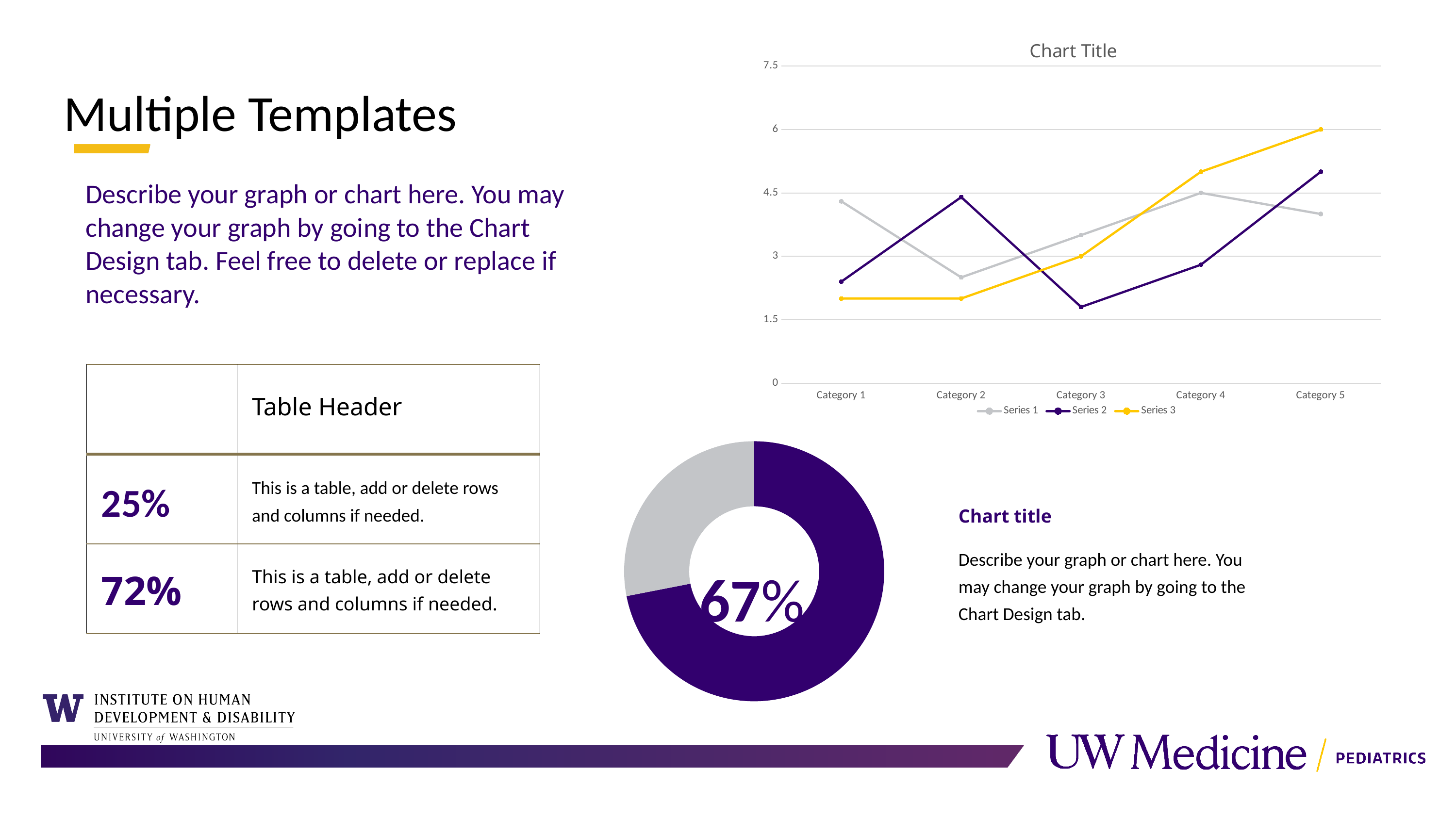
In the chart titled "Chart Title", how many series does the legend list? 3 In the chart titled "Chart Title", is the value for Series 3 at Category 4 greater or less than 4.5? greater In the chart titled "Chart Title", how many categories are shown on the x axis? 5 In the doughnut chart at the bottom centre of the slide, what share does the purple slice represent? 67% In the chart titled "Chart Title", at which category does Series 2 reach its lowest value? Category 3 In the chart titled "Chart Title", is the value for Series 2 at Category 3 greater or less than 3? less What kind of chart is the chart titled "Chart Title" at the top right of the slide? line chart In the chart titled "Chart Title", which series has the larger value at Category 5, Series 1 or Series 3? Series 3 In the chart titled "Chart Title", is the value for Series 1 at Category 1 greater or less than 3? greater In the chart titled "Chart Title", does Series 3 generally rise or fall from Category 1 to Category 5? rise What kind of chart is the chart at the bottom centre of the slide showing 67%? doughnut chart In the chart titled "Chart Title", at which category does Series 3 reach its highest value? Category 5